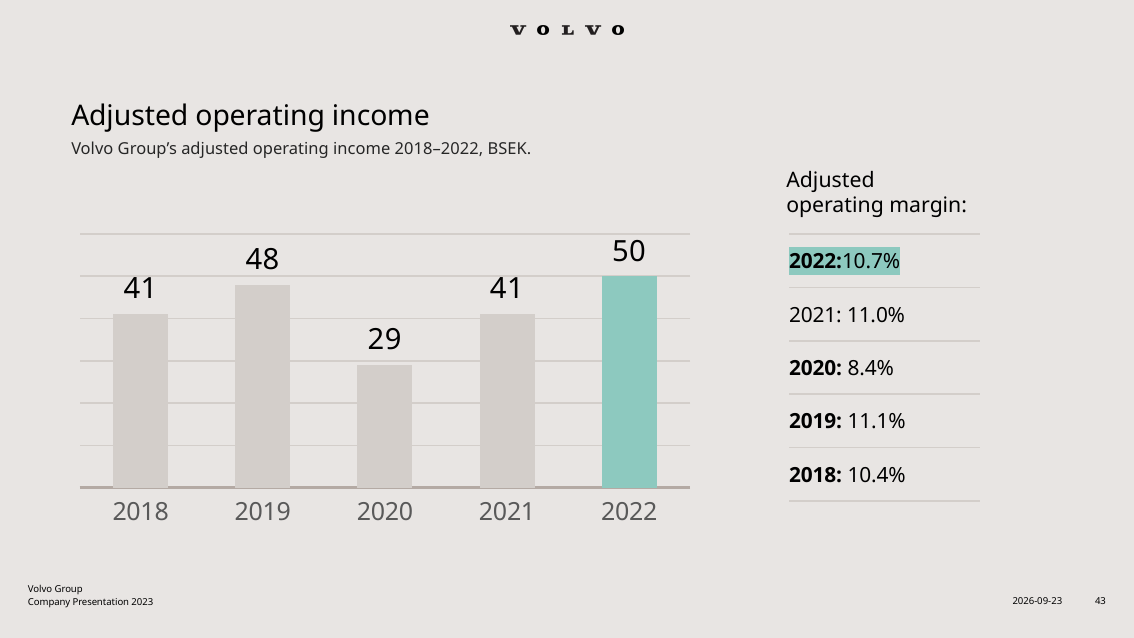
What is the adjusted operating income for 2020? 29 How many years are shown in the chart? 5 What kind of chart is shown on the slide? Bar chart What is the difference between the adjusted operating income in 2022 and in 2020? 21 What is the difference between the adjusted operating income in 2019 and in 2018? 7 Which is larger, the adjusted operating income in 2019 or in 2021? 2019 Which year has the highest adjusted operating income? 2022 What is the adjusted operating income for 2022? 50 Which year has the lowest adjusted operating income? 2020 Did the adjusted operating income rise or fall from 2020 to 2022? Rise Which year's bar is highlighted in a different colour from the others? 2022 What is the adjusted operating income for 2019? 48